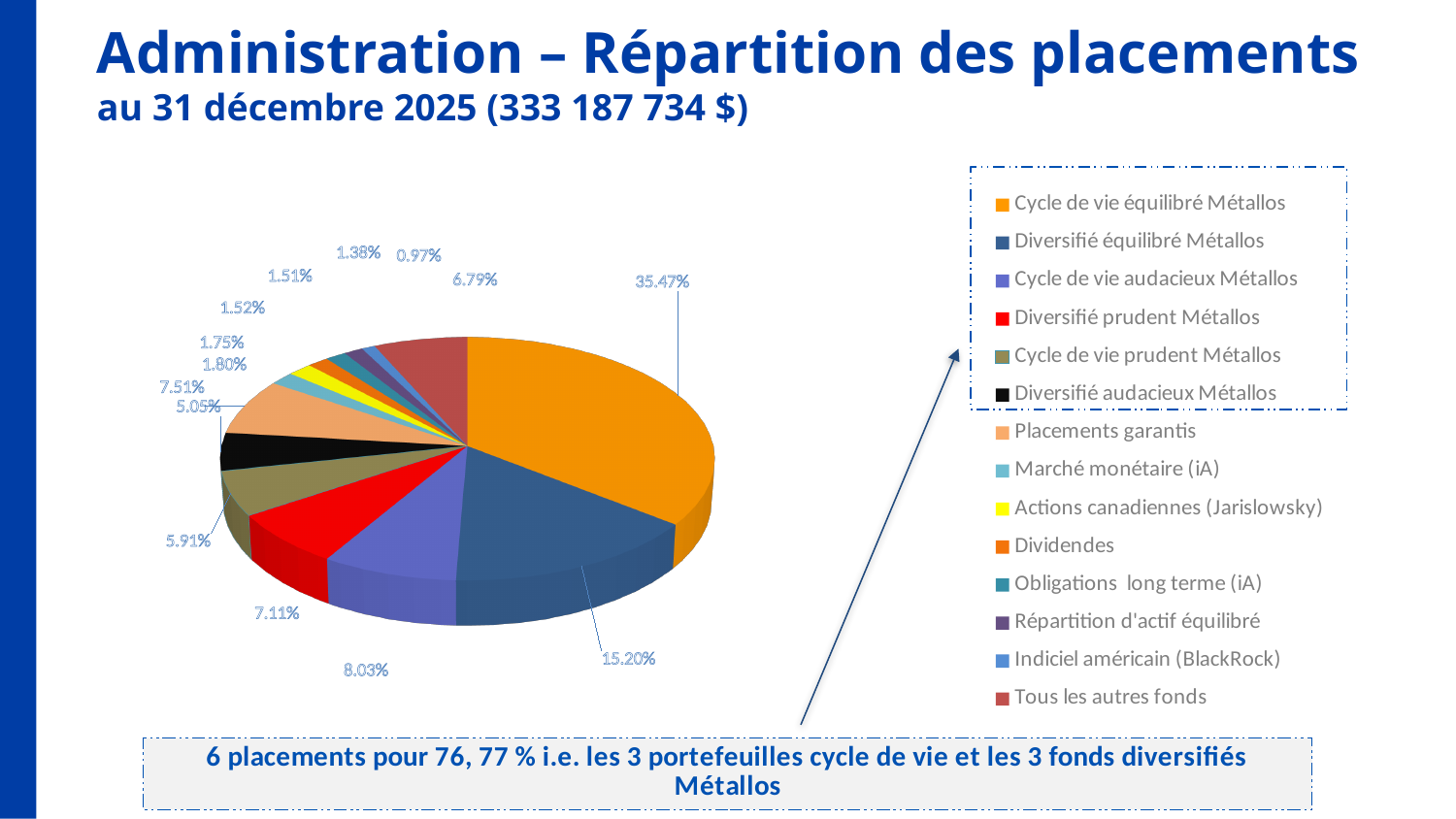
What kind of chart is shown on the slide? pie chart What is the value shown for Tous les autres fonds? 6.79% What is the value shown for Diversifié prudent Métallos? 7.11% What colour is the slice for Diversifié audacieux Métallos? black What share of the pie does Cycle de vie équilibré Métallos represent? 35.47% Which is larger, the slice for Placements garantis or the slice for Cycle de vie prudent Métallos? Placements garantis Which category has the smallest slice of the pie? Indiciel américain (BlackRock) What is the value shown for Cycle de vie audacieux Métallos? 8.03% How many categories does the legend list? 14 What is the difference between the values for Cycle de vie équilibré Métallos and Diversifié équilibré Métallos? 20.27% Which category has the largest slice of the pie? Cycle de vie équilibré Métallos What is the value shown for Diversifié équilibré Métallos? 15.20%